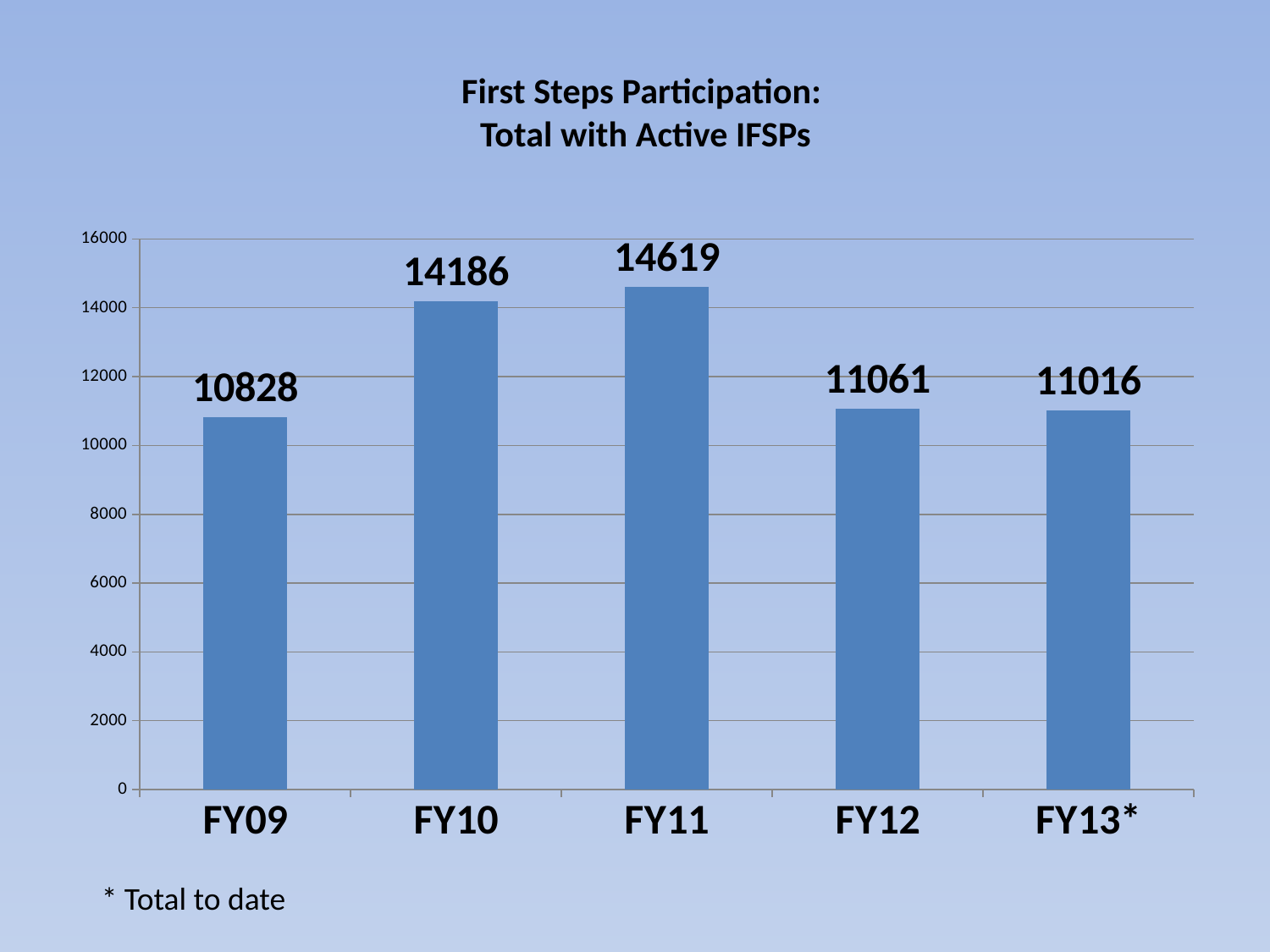
What is the value for FY13*? 11016 What is the value for FY11? 14619 Is the value for FY09 greater or less than 12000? less What is the title of the chart? First Steps Participation: Total with Active IFSPs Which fiscal year has the lowest value? FY09 Which is larger, the value for FY10 or the value for FY12? FY10 How many fiscal years are shown on the chart? 5 What kind of chart is shown on the slide? bar chart Which fiscal year has the highest value? FY11 What is the value for FY09? 10828 What is the difference between the values for FY11 and FY10? 433 What is the difference between the values for FY12 and FY13*? 45